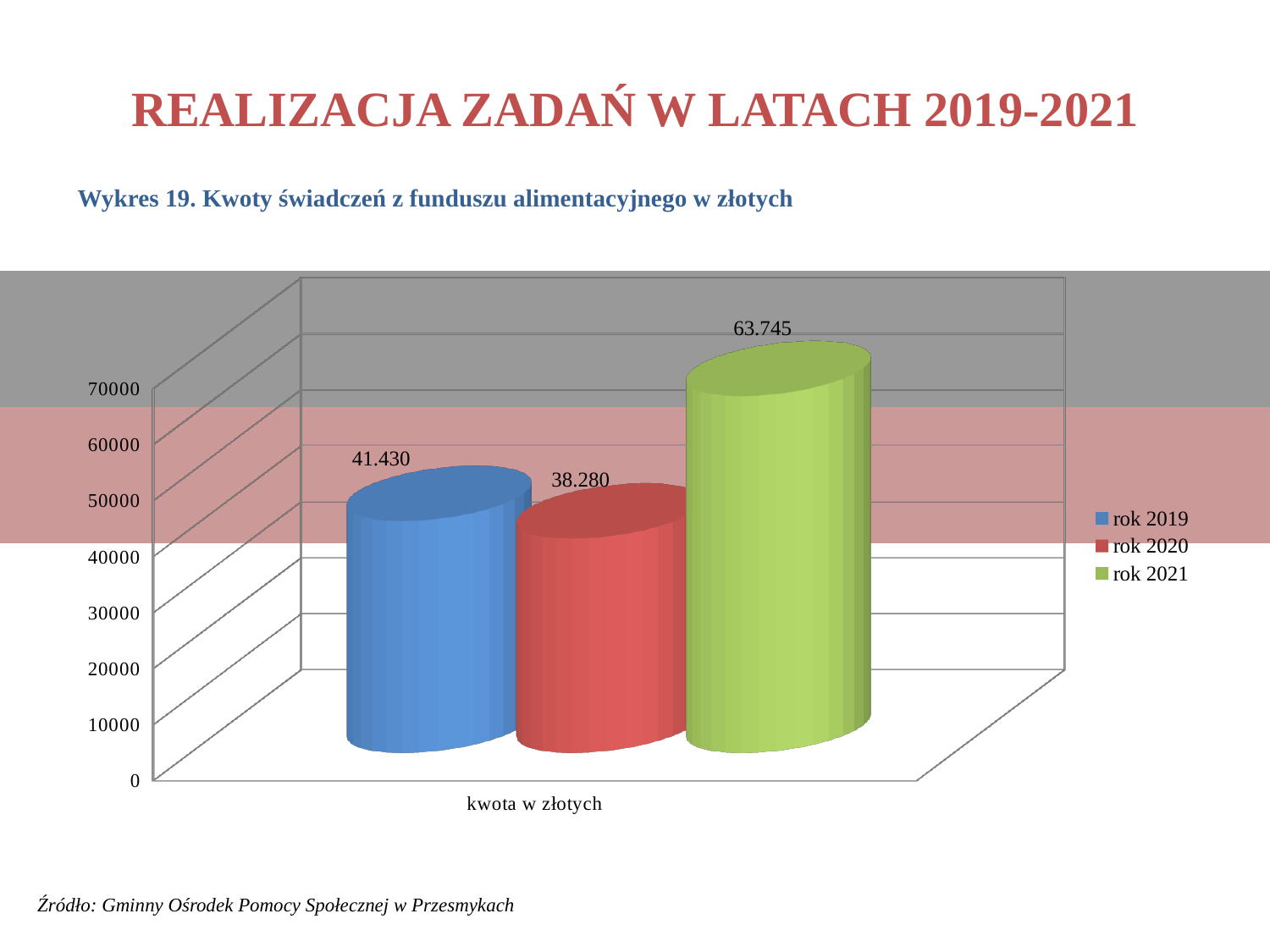
What is the value for rok 2019? 41.430 Which is larger, the value for rok 2019 or the value for rok 2020? rok 2019 How many series does the legend list? 3 What is the value for rok 2020? 38.280 What is the difference between the values for rok 2019 and rok 2020? 3.150 What is the value for rok 2021? 63.745 Which year has the highest value? rok 2021 What is the title of the chart? Wykres 19. Kwoty świadczeń z funduszu alimentacyjnego w złotych What kind of chart is shown on the slide? bar chart Is the value for rok 2021 greater or less than 60000? greater What is the difference between the values for rok 2021 and rok 2019? 22.315 Which year has the lowest value? rok 2020